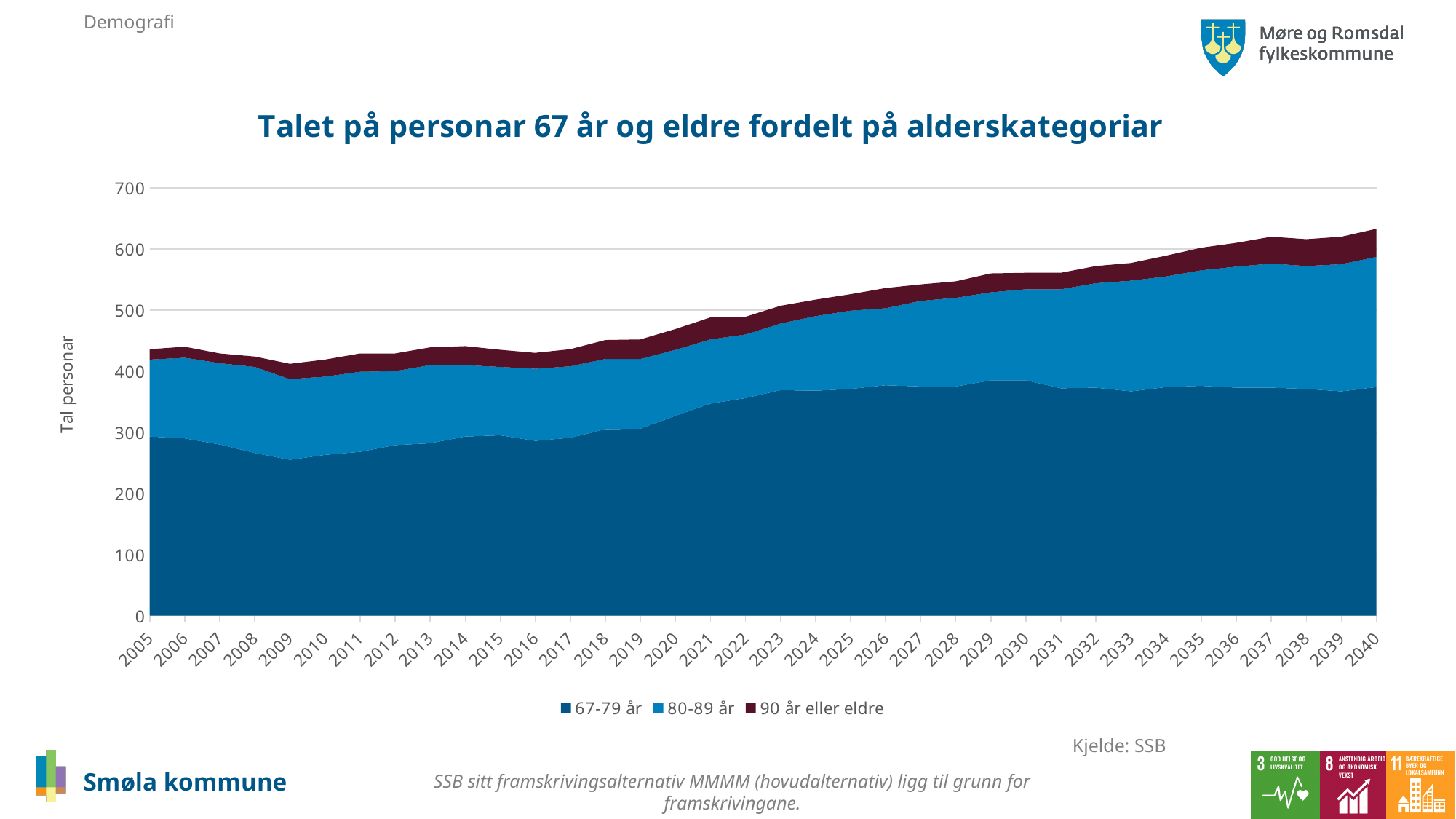
What kind of chart is shown on the slide? Stacked area chart Is the value for 67-79 år in 2040 greater or less than 300? greater Is the total stacked value for 2005 greater or less than 500? less Which year has the larger total stacked value, 2005 or 2040? 2040 How many series does the legend list? 3 What is the title of the chart? Talet på personar 67 år og eldre fordelt på alderskategoriar Is the total stacked value for 2030 greater or less than 500? greater Does the total number of persons 67 år og eldre rise or fall from 2005 to 2040? Rise What is the label on the y axis? Tal personar How many years are shown along the x axis? 36